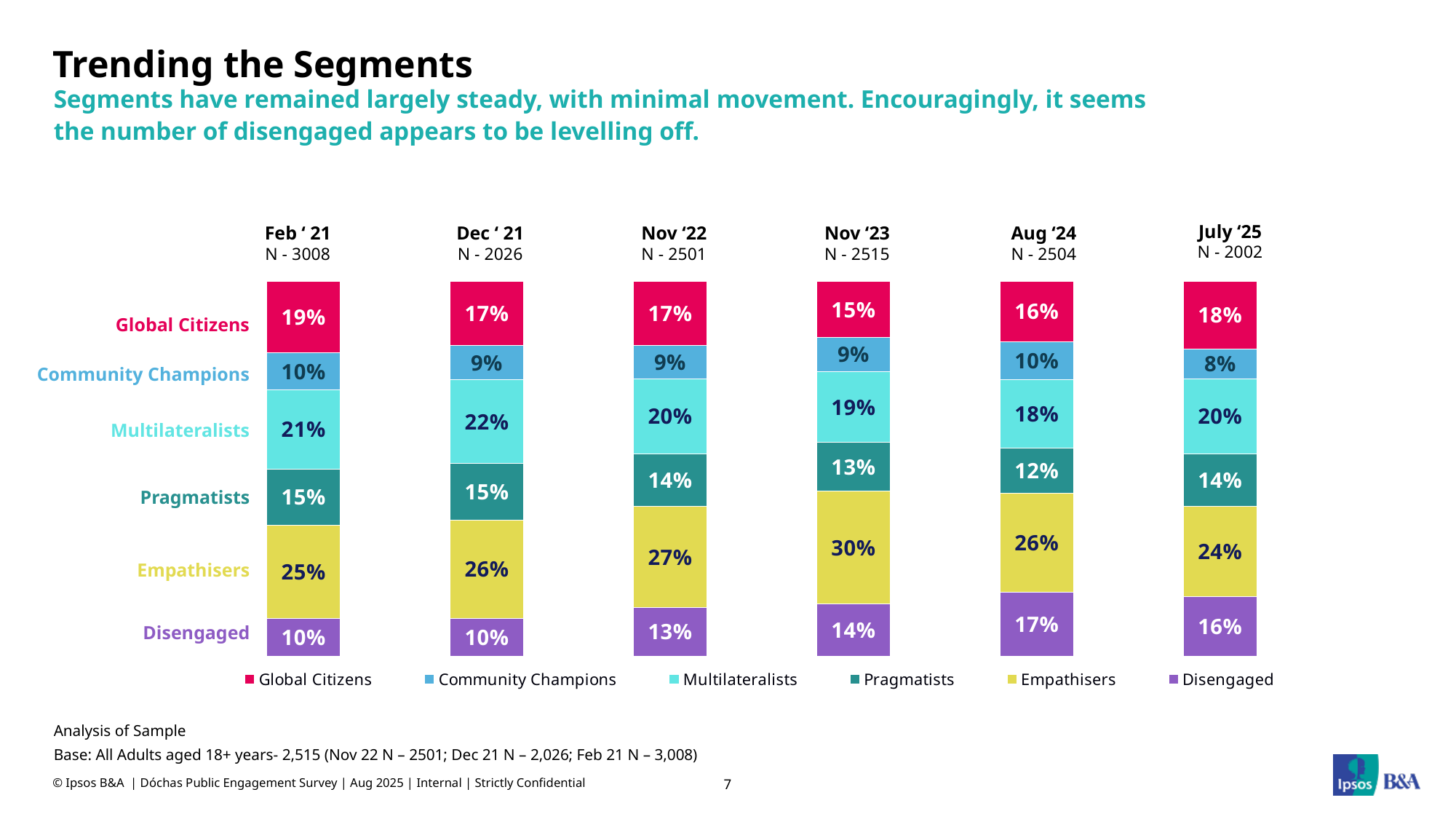
How many series does the legend list? 6 What is the difference between the Disengaged value in Aug '24 and in Feb '21? 7 percentage points What kind of chart is shown on the slide? Stacked bar chart In which period is the Community Champions segment lowest? July '25 What is the value for Empathisers in Nov '23? 30% What is the value for Disengaged in Feb '21? 10% What is the value for Pragmatists in Aug '24? 12% Does the Disengaged segment rise or fall from Feb '21 to Aug '24? Rise In which period is the Empathisers segment highest? Nov '23 How many time periods are shown in the chart? 6 What is the sample size (N) shown for Nov '22? N - 2501 Which is larger: Global Citizens in Feb '21 or Global Citizens in Nov '23? Feb '21